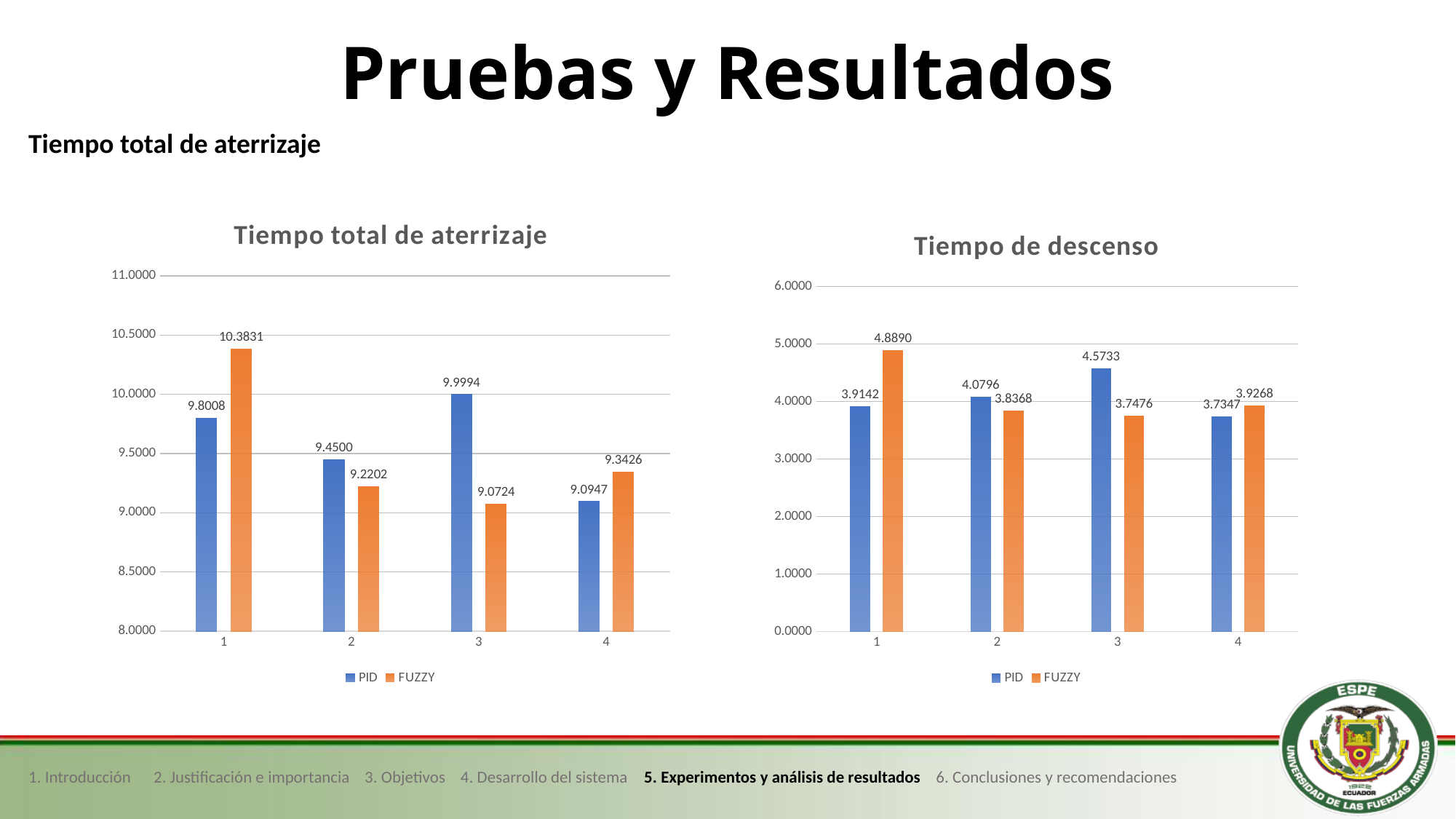
In the 'Tiempo total de aterrizaje' chart, what is the difference between the FUZZY and PID values for category 1? 0.5823 In the 'Tiempo de descenso' chart, what is the difference between the PID and FUZZY values for category 3? 0.8257 In the 'Tiempo total de aterrizaje' chart, what is the FUZZY value for category 1? 10.3831 In the 'Tiempo total de aterrizaje' chart, which category has the lowest FUZZY value? 3 What kind of chart is the 'Tiempo de descenso' chart? Bar chart In the 'Tiempo total de aterrizaje' chart, is the PID value for category 2 greater or less than 9.5000? less How many series does the legend of the 'Tiempo total de aterrizaje' chart list? 2 In the 'Tiempo de descenso' chart, what is the FUZZY value for category 2? 3.8368 In the 'Tiempo de descenso' chart, which category has the highest PID value? 3 In the 'Tiempo total de aterrizaje' chart, what is the PID value for category 3? 9.9994 How many categories are shown on the x axis of the 'Tiempo de descenso' chart? 4 In the 'Tiempo de descenso' chart, which is larger for category 4, PID or FUZZY? FUZZY